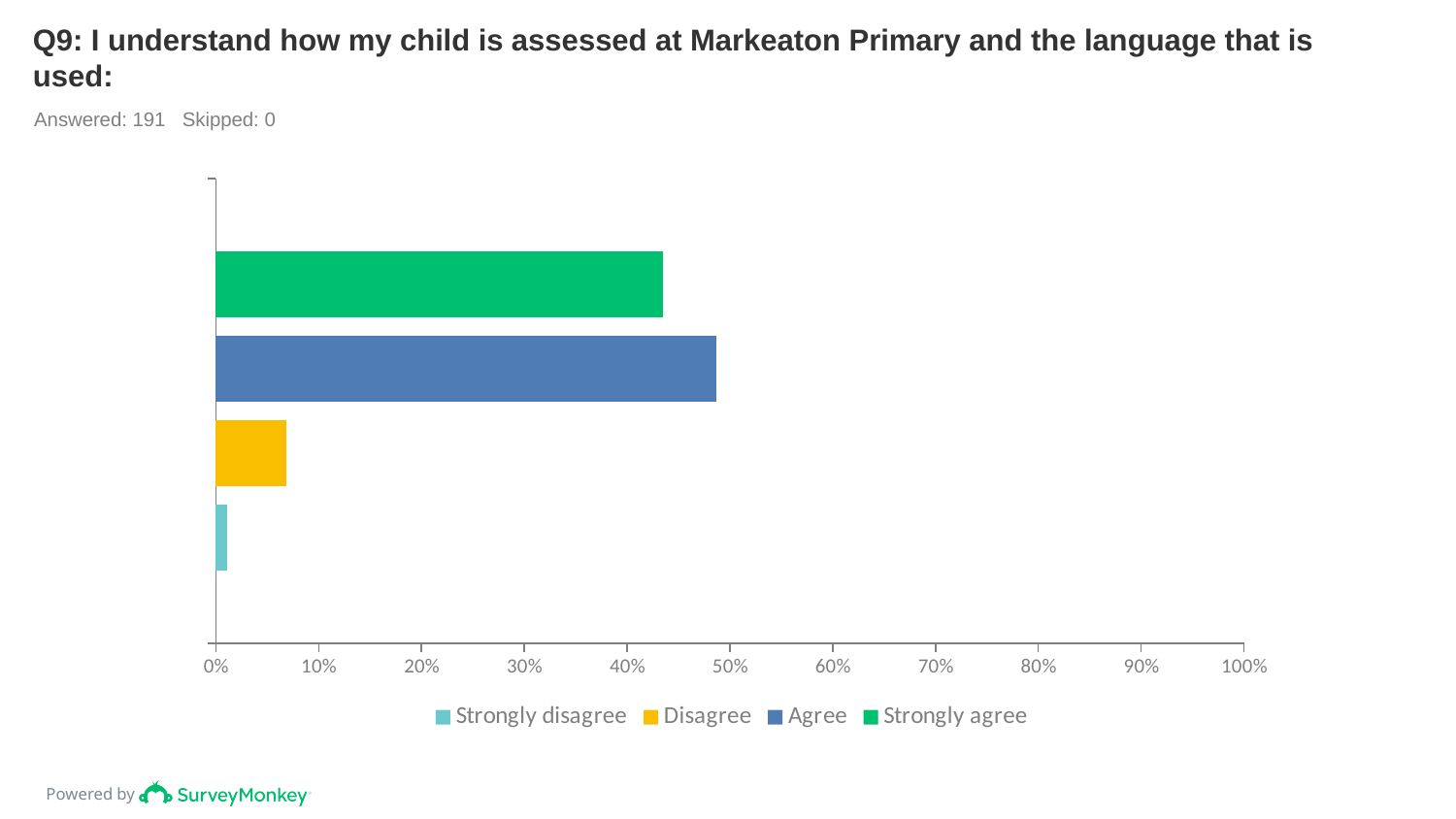
How many respondents answered this question, according to the slide? 191 What colour is the bar for Disagree? Yellow How many bars are plotted in the chart? 4 Is the value for Agree greater or less than 50%? less How many entries does the legend list? 4 What kind of chart is shown on the slide? Bar chart Is the value for Strongly agree greater or less than 40%? greater Which response category has the shortest bar? Strongly disagree Is the value for Disagree greater or less than 10%? less Which is larger, the value for Disagree or the value for Strongly disagree? Disagree Which is larger, the value for Agree or the value for Strongly agree? Agree Which response category has the longest bar? Agree